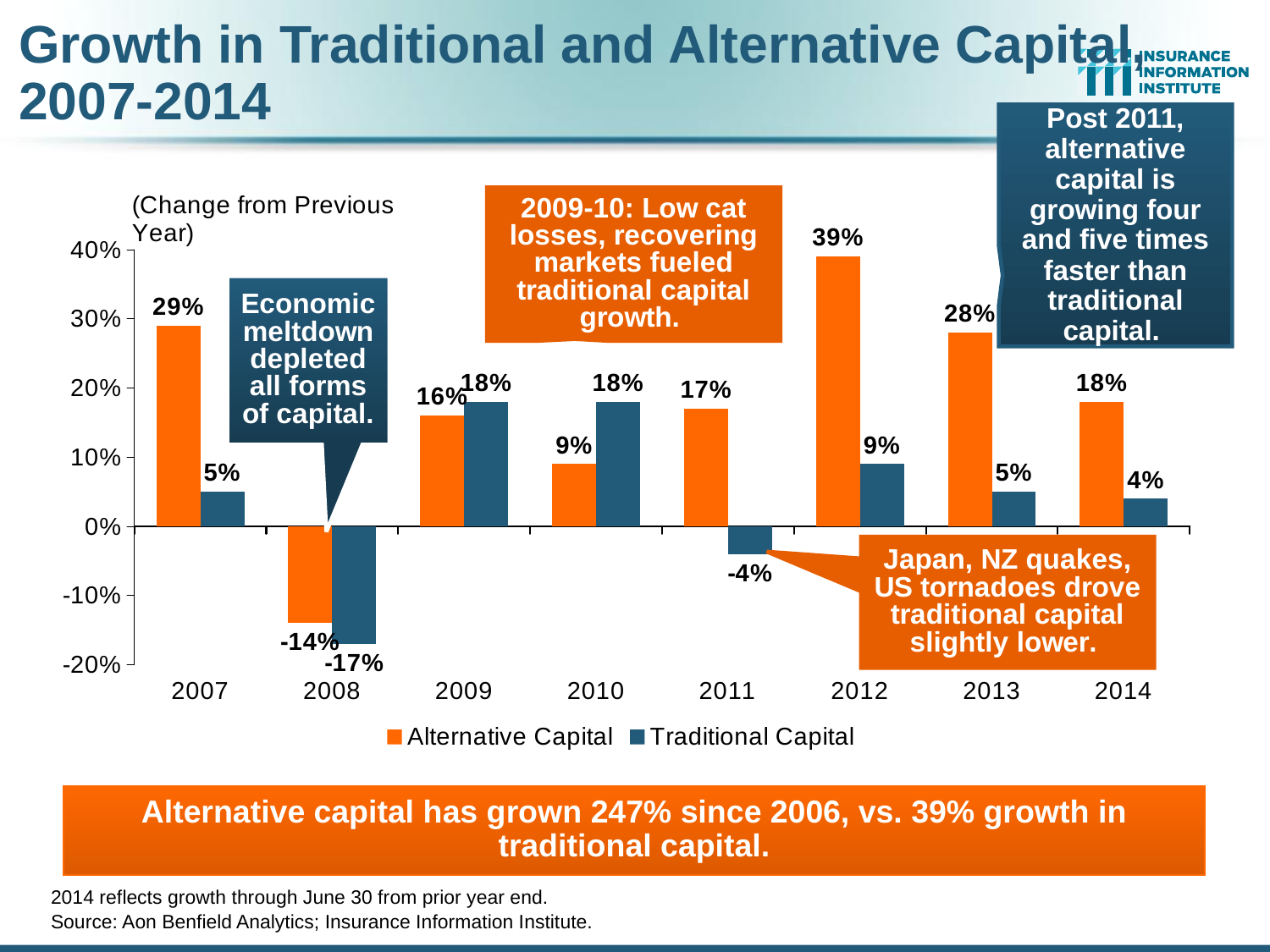
What is the difference between Alternative Capital and Traditional Capital in 2012? 30% How many years are shown on the x axis? 8 How many series does the legend list? 2 What is the value for Alternative Capital in 2012? 39% What is the value for Traditional Capital in 2011? -4% What kind of chart is shown on the slide? Bar chart What is the value for Traditional Capital in 2014? 4% In which year is Traditional Capital growth lowest? 2008 Which colour represents Alternative Capital in the chart? Orange What is the value for Alternative Capital in 2008? -14% Which is larger in 2010, Alternative Capital or Traditional Capital? Traditional Capital In which year is Alternative Capital growth highest? 2012